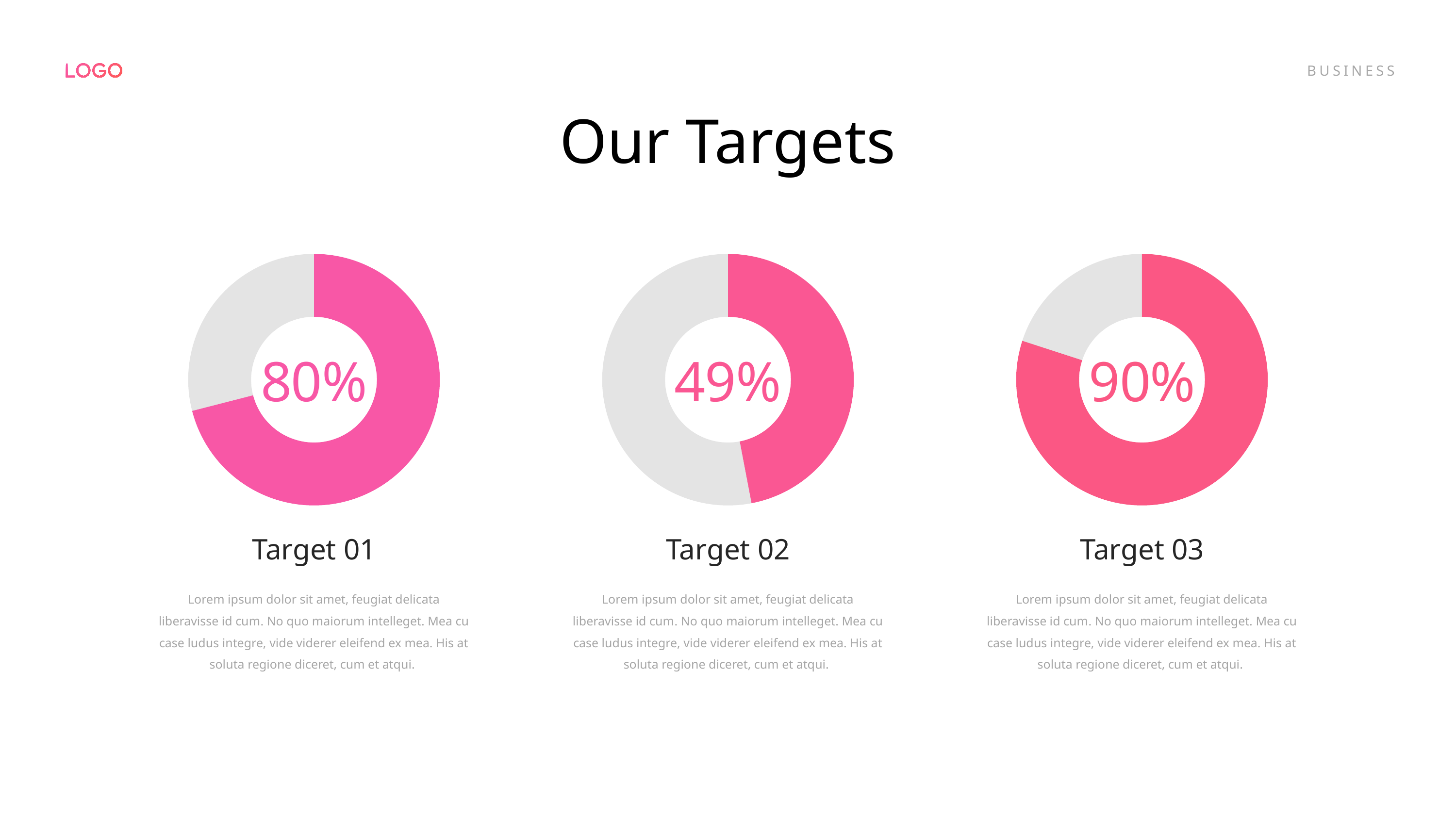
What is the difference between the Target 01 and Target 02 percentages? 31% What percentage is shown in the Target 02 chart? 49% What is the difference between the Target 03 and Target 01 percentages? 10% Which target has the highest percentage? Target 03 What kind of chart is used for each target? Donut chart What percentage is shown in the Target 01 chart? 80% What percentage is shown in the Target 03 chart? 90% Is the Target 02 percentage greater or less than 50%? less Which target has the lowest percentage? Target 02 Which is larger, the Target 01 percentage or the Target 02 percentage? Target 01 How many donut charts are on the slide? 3 What is the title of the slide containing the charts? Our Targets